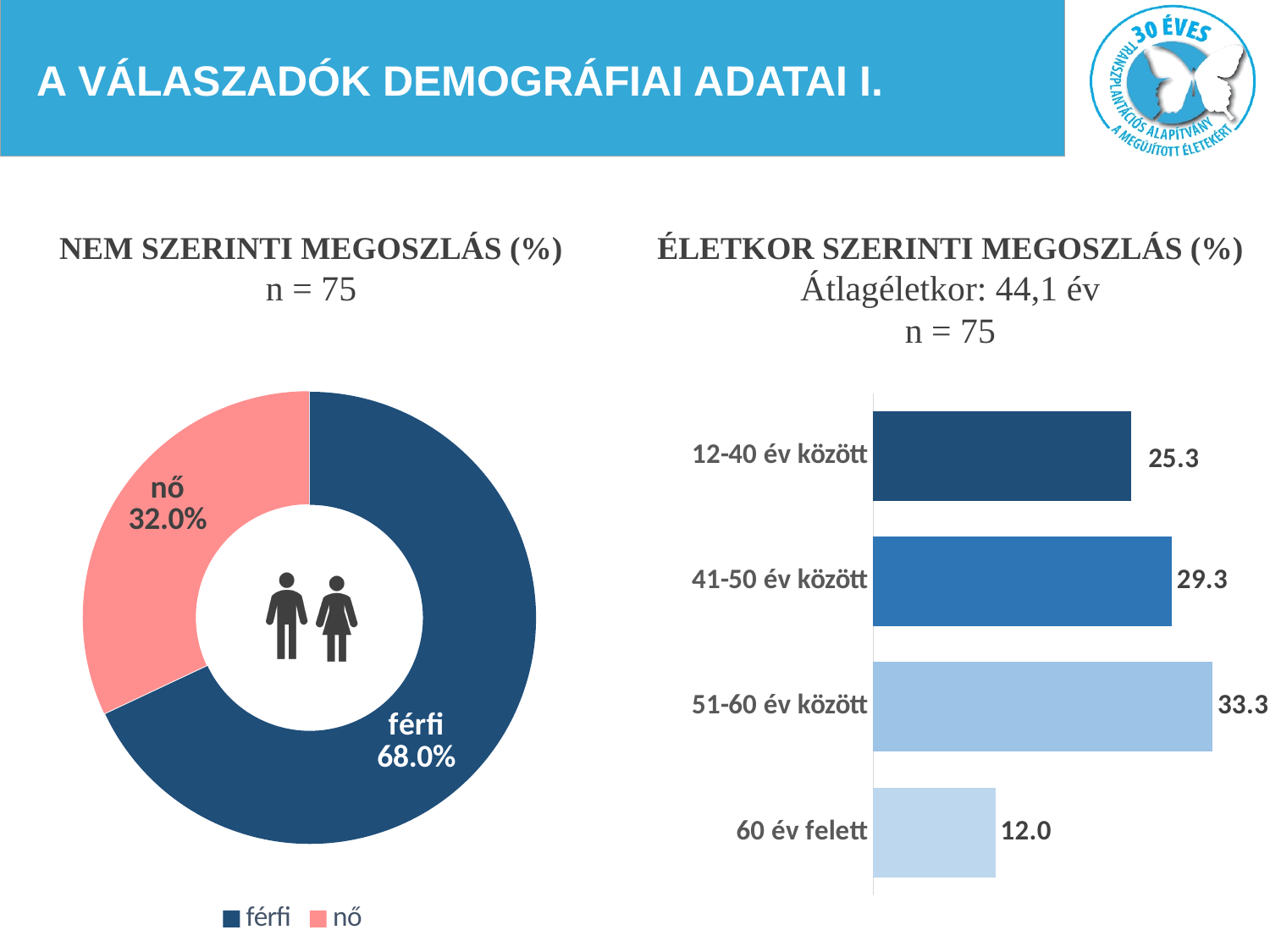
In the 'NEM SZERINTI MEGOSZLÁS (%)' chart, what is the difference between the férfi and nő shares? 36.0% How many entries does the legend of the 'NEM SZERINTI MEGOSZLÁS (%)' chart list? 2 In the 'ÉLETKOR SZERINTI MEGOSZLÁS (%)' chart, what is the difference between 51-60 év között and 12-40 év között? 8.0 In the 'NEM SZERINTI MEGOSZLÁS (%)' chart, what is the value for nő? 32.0% In the 'ÉLETKOR SZERINTI MEGOSZLÁS (%)' chart, what is the value for 60 év felett? 12.0 In the 'NEM SZERINTI MEGOSZLÁS (%)' chart, which category has the larger share? férfi What kind of chart is the 'NEM SZERINTI MEGOSZLÁS (%)' chart? doughnut chart In the 'NEM SZERINTI MEGOSZLÁS (%)' chart, what is the value for férfi? 68.0% In the 'ÉLETKOR SZERINTI MEGOSZLÁS (%)' chart, what is the value for 41-50 év között? 29.3 In the 'ÉLETKOR SZERINTI MEGOSZLÁS (%)' chart, which age group has the highest value? 51-60 év között In the 'ÉLETKOR SZERINTI MEGOSZLÁS (%)' chart, which age group has the lowest value? 60 év felett How many age categories are shown in the 'ÉLETKOR SZERINTI MEGOSZLÁS (%)' chart? 4